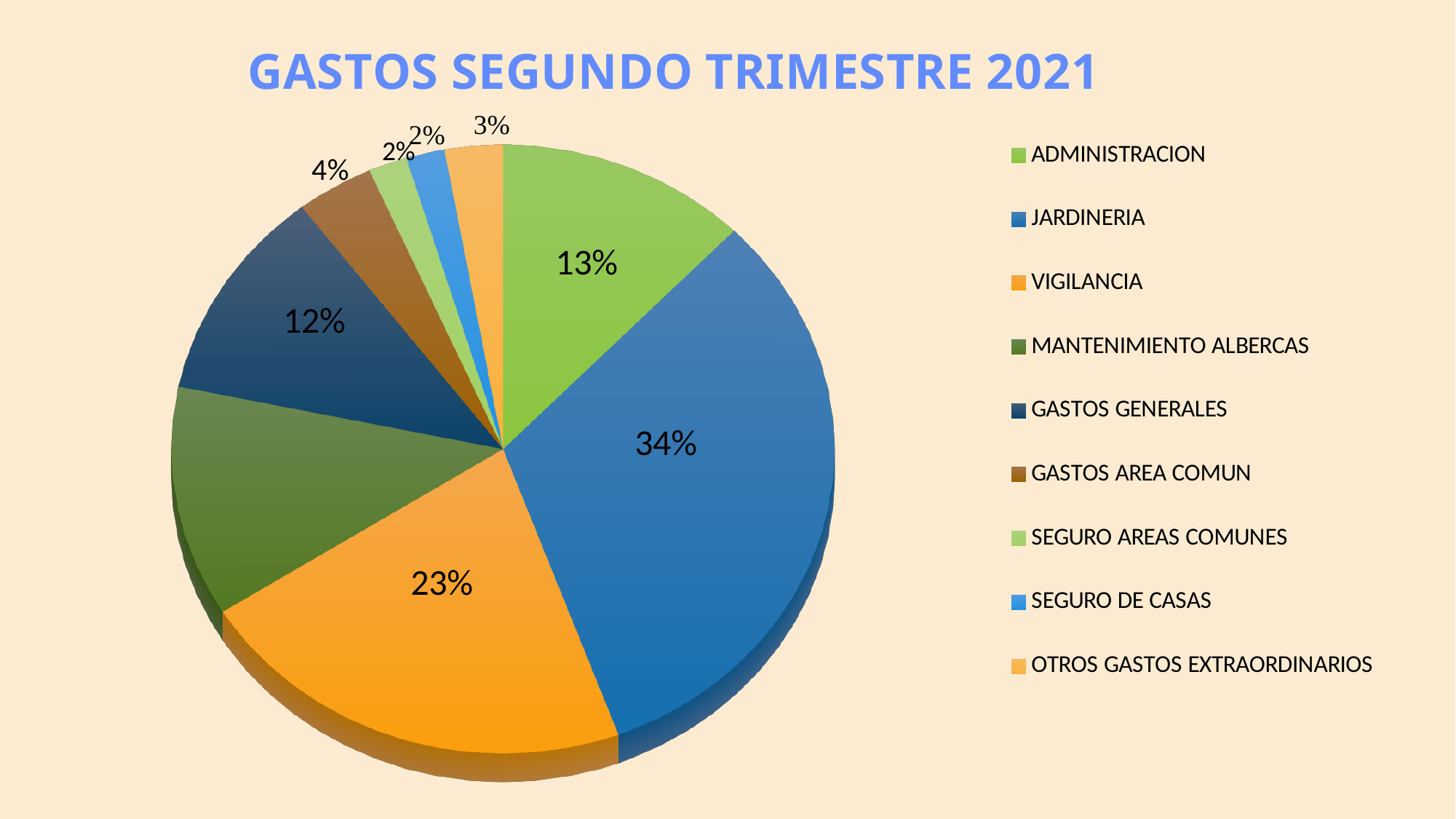
What share of the pie does VIGILANCIA represent? 23% What share of the pie does GASTOS AREA COMUN represent? 4% What share of the pie does GASTOS GENERALES represent? 12% What is the title of the chart? GASTOS SEGUNDO TRIMESTRE 2021 What type of chart is shown on the slide? Pie chart Which category has the largest share of the pie? JARDINERIA Which is larger, the share for ADMINISTRACION or the share for GASTOS GENERALES? ADMINISTRACION What is the difference in percentage points between JARDINERIA and VIGILANCIA? 11 How many categories does the legend list? 9